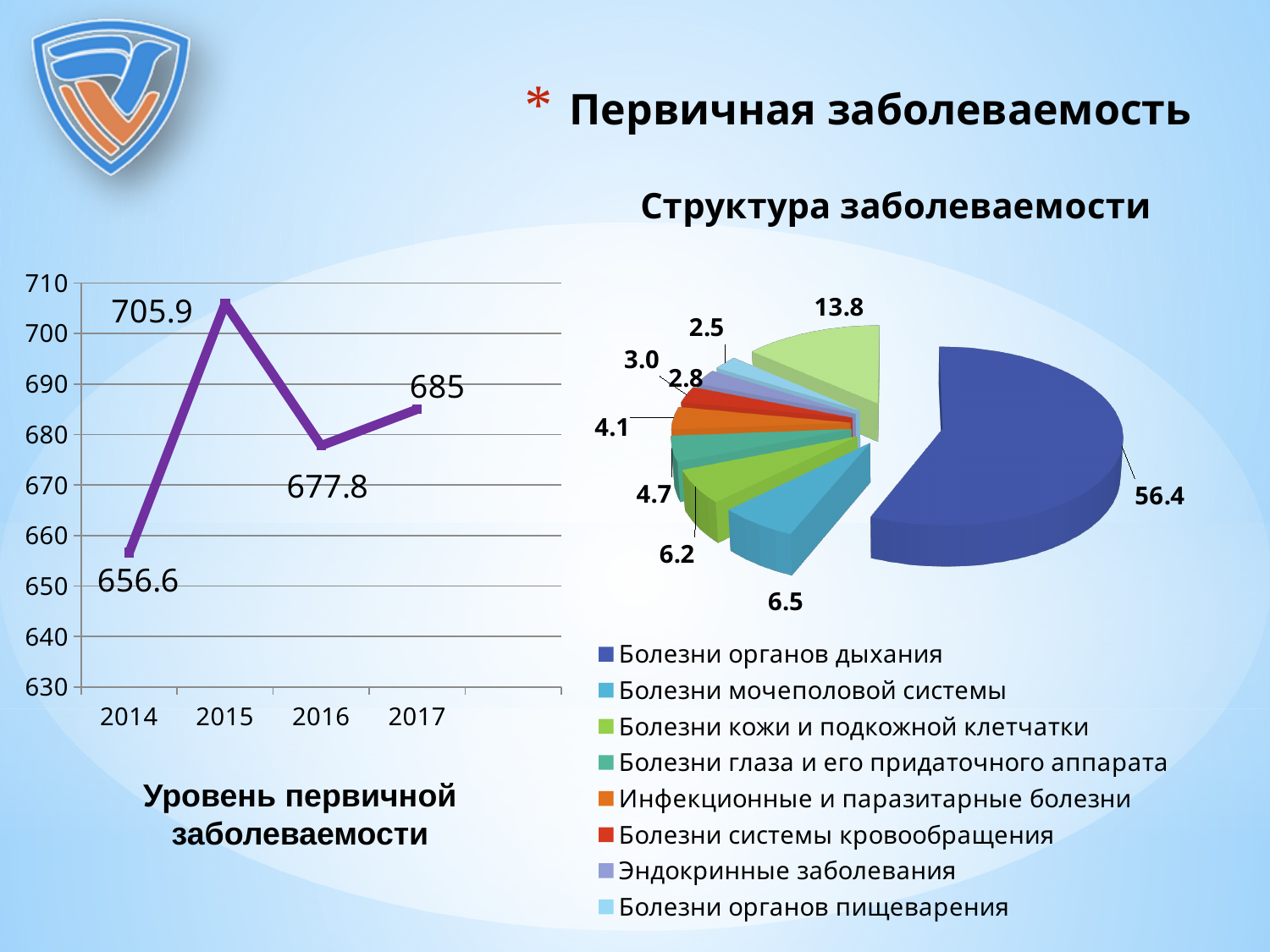
On the pie chart 'Структура заболеваемости', what is the value for 'Болезни мочеполовой системы'? 6.5 How many entries does the legend of the pie chart 'Структура заболеваемости' list? 8 On the line chart 'Уровень первичной заболеваемости', is the value for 2017 greater or less than the value for 2016? greater On the line chart 'Уровень первичной заболеваемости', which year has the highest value? 2015 On the line chart 'Уровень первичной заболеваемости', what is the value for 2014? 656.6 On the line chart 'Уровень первичной заболеваемости', what is the difference between the 2015 and 2016 values? 28.1 On the line chart 'Уровень первичной заболеваемости', what is the value for 2015? 705.9 What kind of chart is 'Уровень первичной заболеваемости'? line chart On the line chart 'Уровень первичной заболеваемости', how many years are plotted? 4 On the line chart 'Уровень первичной заболеваемости', which year has the lowest value? 2014 On the pie chart 'Структура заболеваемости', which legend category has the largest slice? Болезни органов дыхания On the pie chart 'Структура заболеваемости', what is the value for 'Болезни органов дыхания'? 56.4